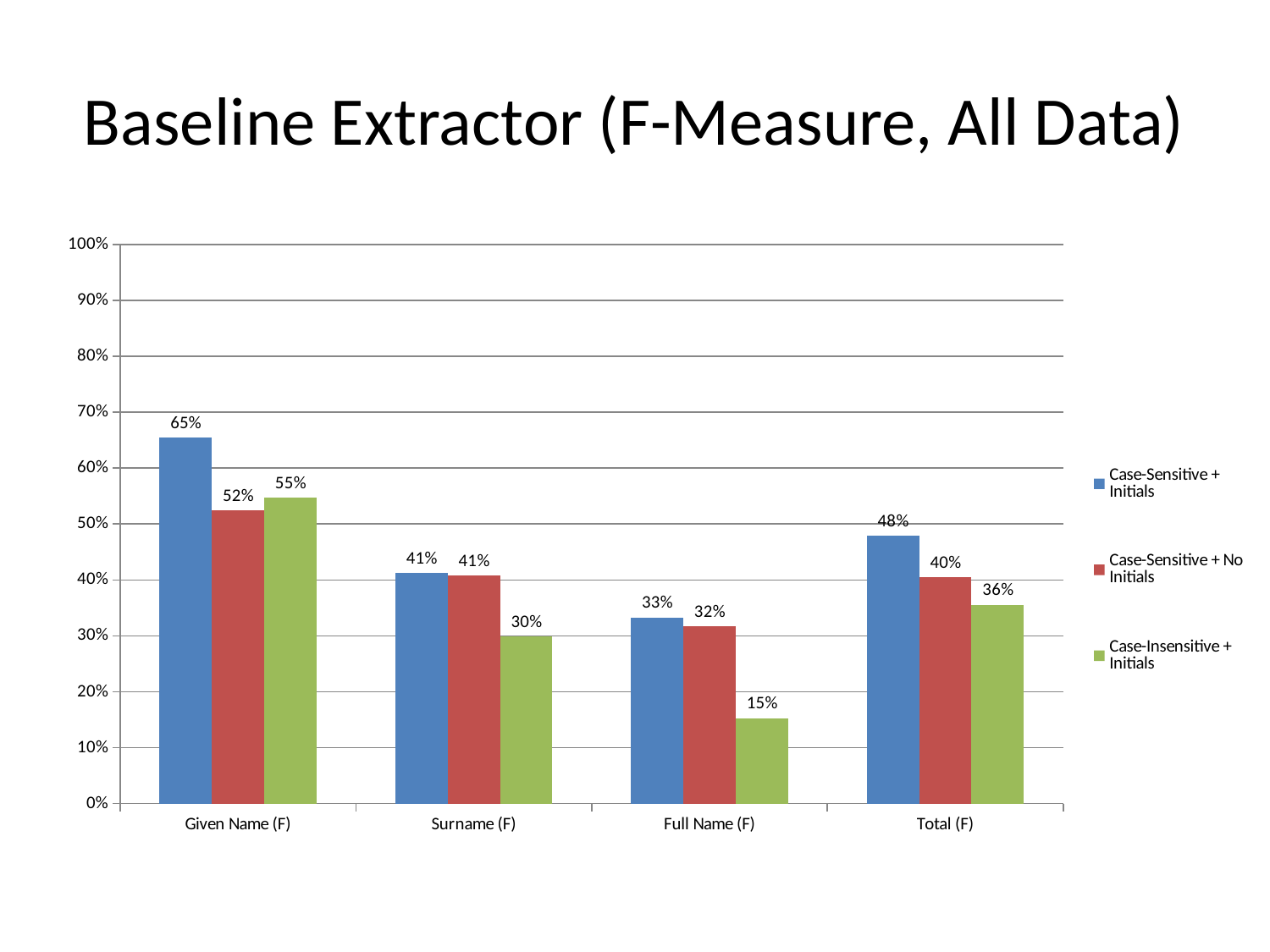
What is the value for Case-Sensitive + No Initials in the Total (F) category? 40% How many categories are shown on the x axis? 4 What is the difference between Case-Sensitive + Initials and Case-Insensitive + Initials in the Total (F) category? 12% In the Given Name (F) category, which is larger: Case-Sensitive + No Initials or Case-Insensitive + Initials? Case-Insensitive + Initials What is the value for Case-Sensitive + Initials in the Given Name (F) category? 65% What is the value for Case-Insensitive + Initials in the Full Name (F) category? 15% Which category has the highest value for Case-Sensitive + Initials? Given Name (F) What kind of chart is shown on the slide? bar chart Which category has the lowest value for Case-Insensitive + Initials? Full Name (F) What is the title of the slide? Baseline Extractor (F-Measure, All Data) How many series does the legend list? 3 Is the value for Case-Sensitive + Initials in the Surname (F) category greater or less than 50%? less